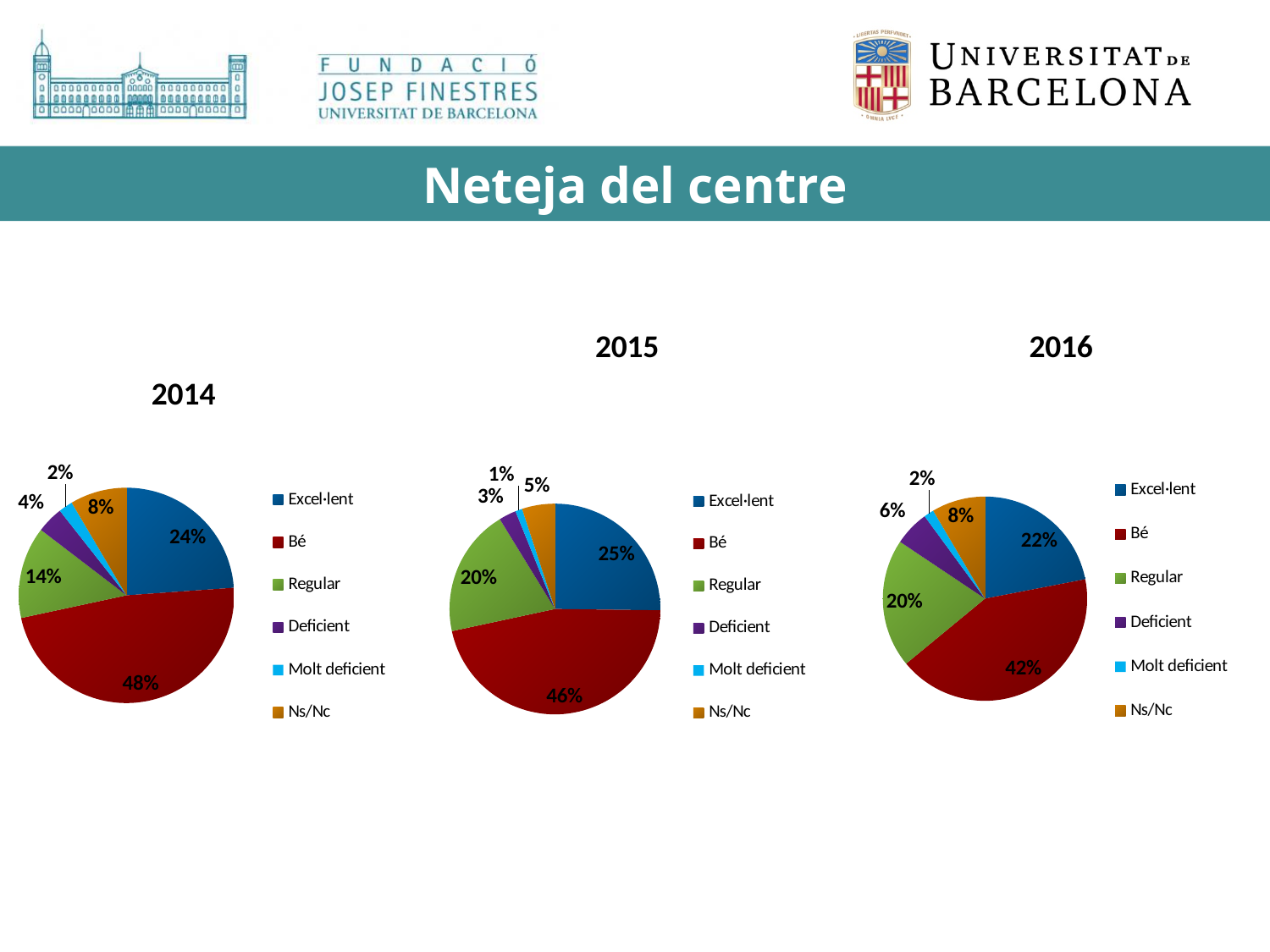
What is the title of the slide containing the three pie charts? Neteja del centre In the 2014 pie chart, what share is labelled for Bé? 48% In the 2015 pie chart, what share is labelled for Regular? 20% In the 2015 pie chart, which category has the smallest slice? Molt deficient How many pie charts are shown on the slide? 3 In the 2014 pie chart, what is the difference between the Bé share and the Excel·lent share? 24% What type of chart is used for the 2014 data? Pie chart In the 2015 pie chart, what share is labelled for Ns/Nc? 5% In the 2016 pie chart, what share is labelled for Deficient? 6% How many slices does the 2015 pie chart have? 6 In the 2016 pie chart, which is larger, the Regular slice or the Ns/Nc slice? Regular In the 2016 pie chart, which category has the largest slice? Bé